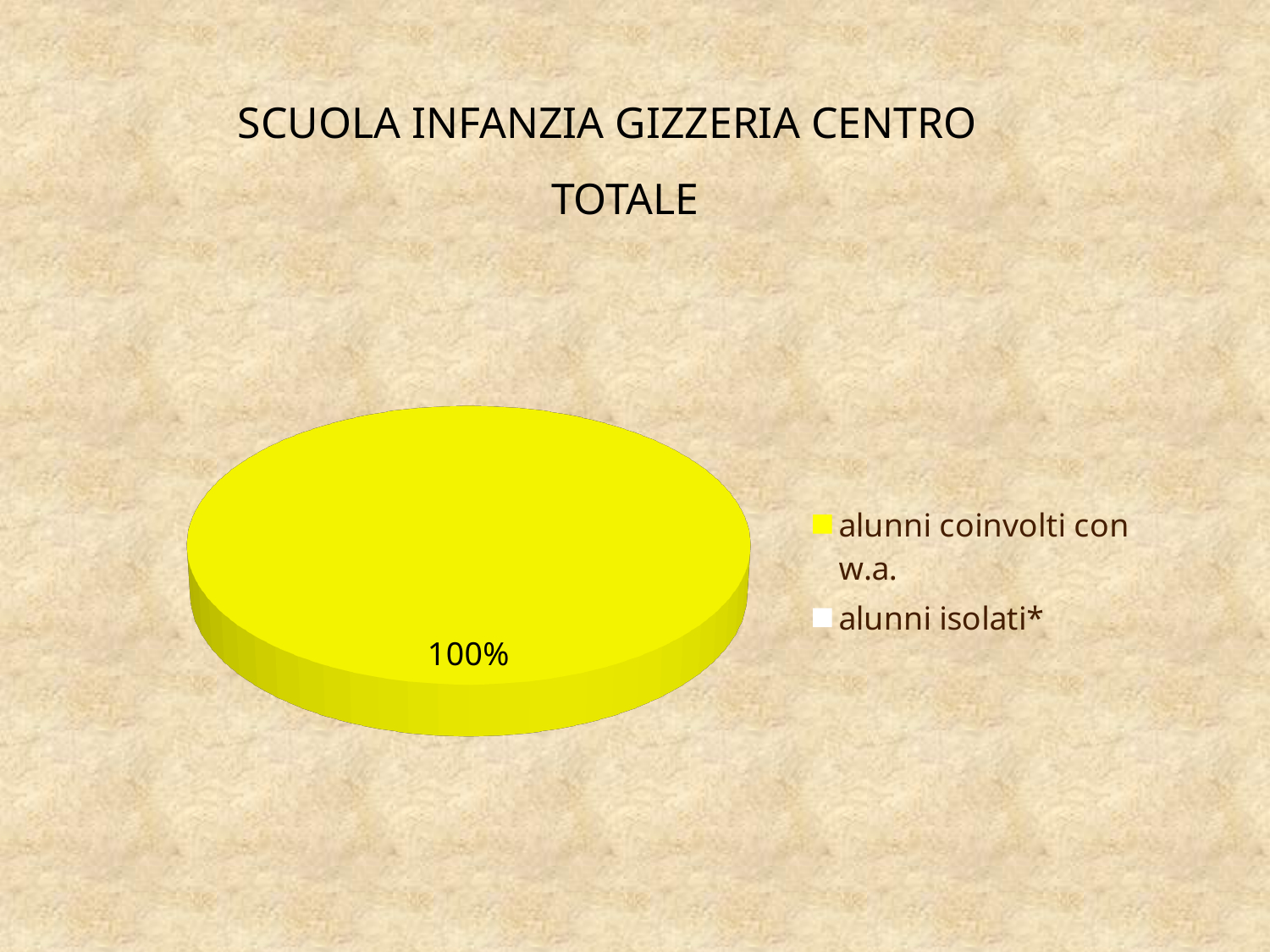
What kind of chart is shown on the slide? pie chart Which legend category accounts for the whole pie? alunni coinvolti con w.a. What share of the pie does "alunni coinvolti con w.a." represent? 100% What colour is the slice for "alunni coinvolti con w.a."? yellow Which is larger, the share for "alunni coinvolti con w.a." or for "alunni isolati*"? alunni coinvolti con w.a. What is the data label printed on the pie chart? 100% How many entries does the legend list? 2 Which legend category has no visible slice in the pie? alunni isolati* What is the title of the chart? SCUOLA INFANZIA GIZZERIA CENTRO TOTALE